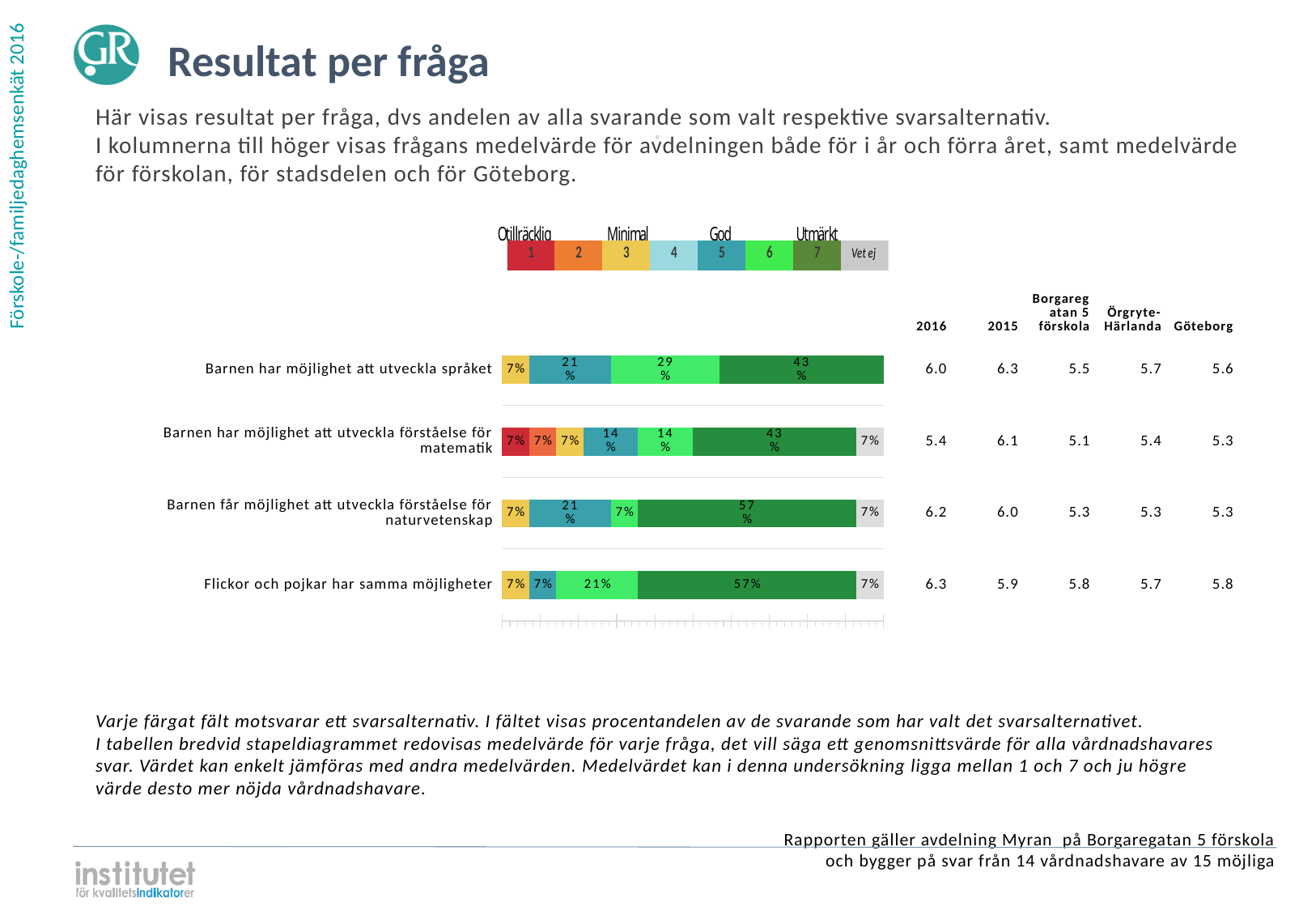
What percentage of respondents answered 'Vet ej' for 'Flickor och pojkar har samma möjligheter'? 7% What percentage of respondents chose rating 6 (light green) for 'Barnen har möjlighet att utveckla språket'? 29% Which has a larger share of rating 5 (teal) responses: 'Barnen har möjlighet att utveckla språket' or 'Flickor och pojkar har samma möjligheter'? Barnen har möjlighet att utveckla språket How many response options does the legend above the chart list? 8 How many questions (categories) are shown in the bar chart? 4 Which question is the only one with responses in the red (1) and orange (2) categories? Barnen har möjlighet att utveckla förståelse för matematik What kind of chart is used to show the results per question? Stacked bar chart What percentage of respondents chose rating 1 (red) for 'Barnen har möjlighet att utveckla förståelse för matematik'? 7% What percentage of respondents chose the highest rating (7, dark green) for 'Barnen får möjlighet att utveckla förståelse för naturvetenskap'? 57% What is the difference between the share choosing rating 7 for 'Barnen får möjlighet att utveckla förståelse för naturvetenskap' and for 'Barnen har möjlighet att utveckla förståelse för matematik'? 14 percentage points What percentage of respondents chose the highest rating (7, dark green) for 'Barnen har möjlighet att utveckla språket'? 43% Which question has the largest share of respondents choosing rating 6 (light green)? Barnen har möjlighet att utveckla språket